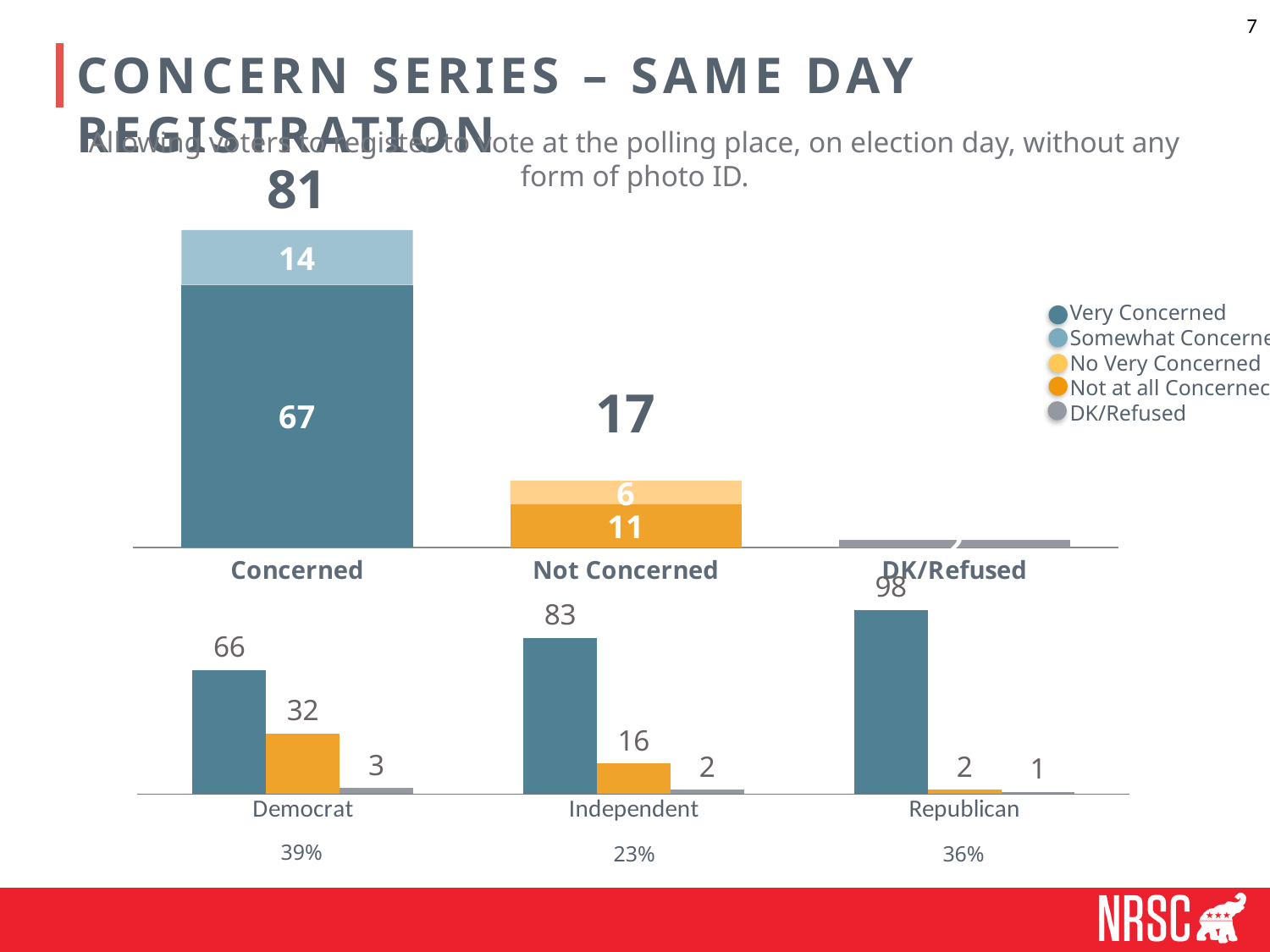
How many entries does the legend of the top chart list? 5 In the top stacked bar chart, what is the total for the Not Concerned bar? 17 In the bottom chart by party, which party has the highest dark teal bar? Republican In the bottom chart by party, what is the value of the orange bar for Democrat? 32 What kind of chart is the top chart on the slide? Stacked bar chart In the top stacked bar chart, what is the total for the Concerned bar? 81 In the top stacked bar chart, what is the difference between the Concerned total and the Not Concerned total? 64 In the top stacked bar chart, what is the Somewhat Concerned value within the Concerned bar? 14 In the top stacked bar chart, what is the Not at all Concerned value within the Not Concerned bar? 11 In the bottom chart by party, what is the difference between the dark teal bars for Republican and Democrat? 32 In the bottom chart by party, what is the value of the dark teal bar for Independent? 83 In the top stacked bar chart, what is the Very Concerned value within the Concerned bar? 67